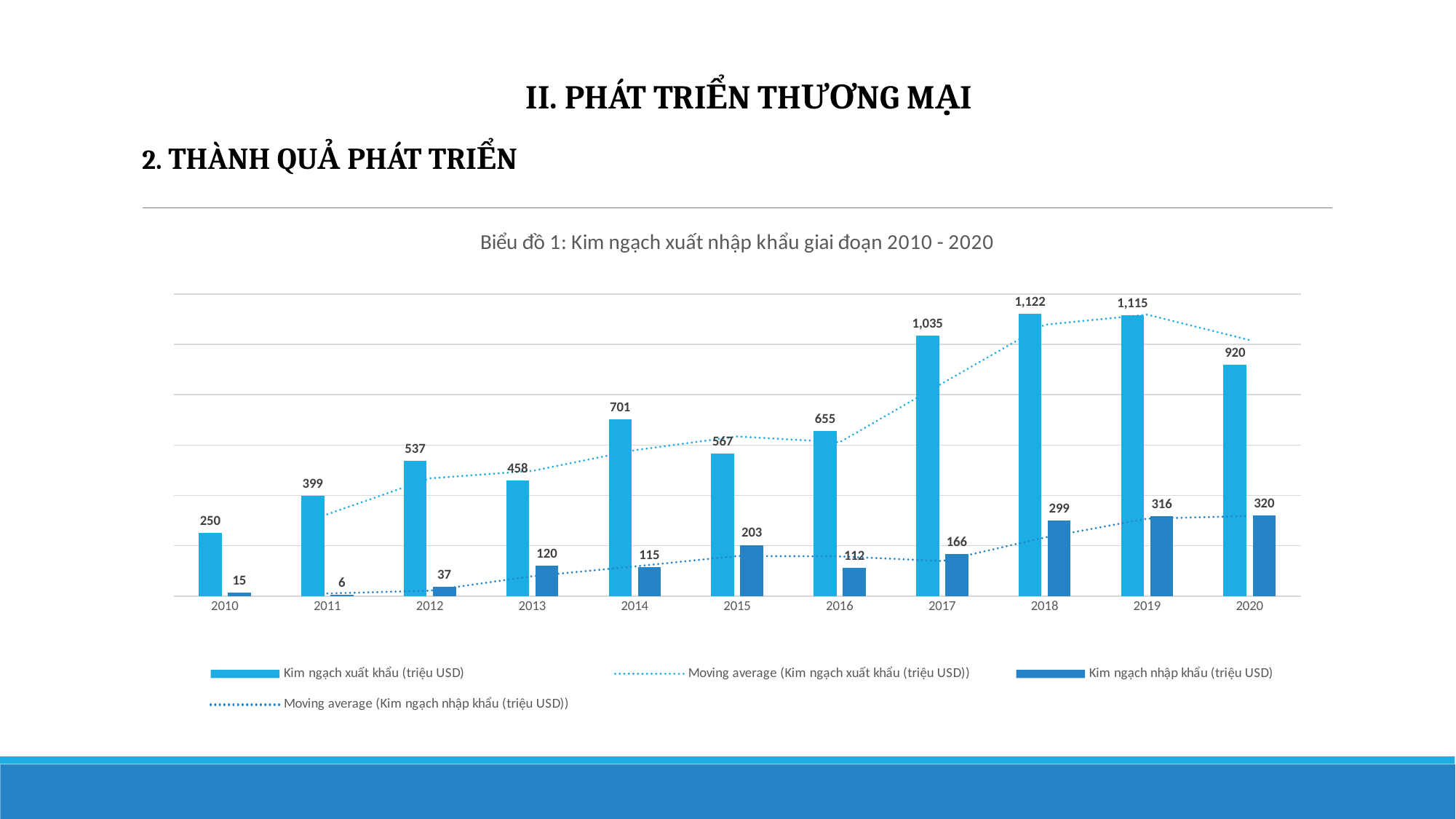
What is the title of the chart? Biểu đồ 1: Kim ngạch xuất nhập khẩu giai đoạn 2010 - 2020 How many entries does the chart legend list? 4 Does Kim ngạch nhập khẩu (triệu USD) generally rise or fall from 2010 to 2020? Rise Which is larger: Kim ngạch xuất khẩu in 2014 or in 2016? 2014 What is the difference between Kim ngạch xuất khẩu in 2018 and in 2019? 7 What kind of chart is used to show Kim ngạch xuất khẩu and Kim ngạch nhập khẩu? Bar chart What is the value of Kim ngạch nhập khẩu (triệu USD) in 2015? 203 In which year is Kim ngạch xuất khẩu (triệu USD) highest? 2018 What is the value of Kim ngạch xuất khẩu (triệu USD) in 2017? 1,035 What is the difference between Kim ngạch xuất khẩu and Kim ngạch nhập khẩu in 2020? 600 In which year is Kim ngạch nhập khẩu (triệu USD) lowest? 2011 How many years are shown on the x axis of the chart? 11